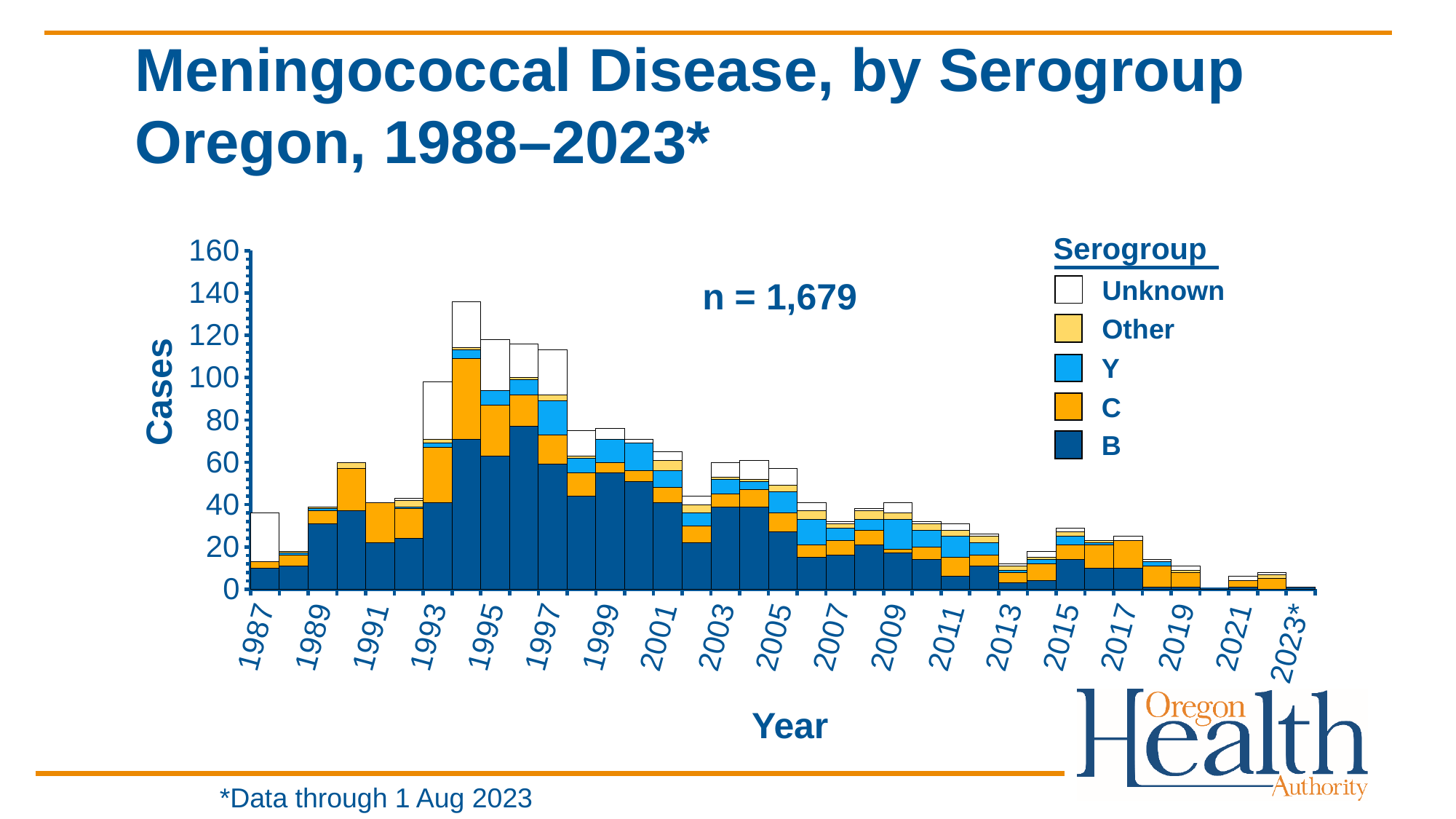
Is the total number of cases in 1995 greater or less than 100? greater Is the total number of cases in 2021 greater or less than 20? less What kind of chart is shown on the slide? Stacked bar chart What is the label on the vertical axis? Cases Which serogroup is shown in dark blue at the bottom of each bar? B Which year has the highest total number of cases? 1994 What total number of cases (n) is printed on the chart? n = 1,679 Do total cases generally rise or fall from 1994 to 2023? fall Is the total number of cases in 1994 greater or less than 120? greater How many serogroups does the legend list? 5 Which year has more total cases, 1994 or 2010? 1994